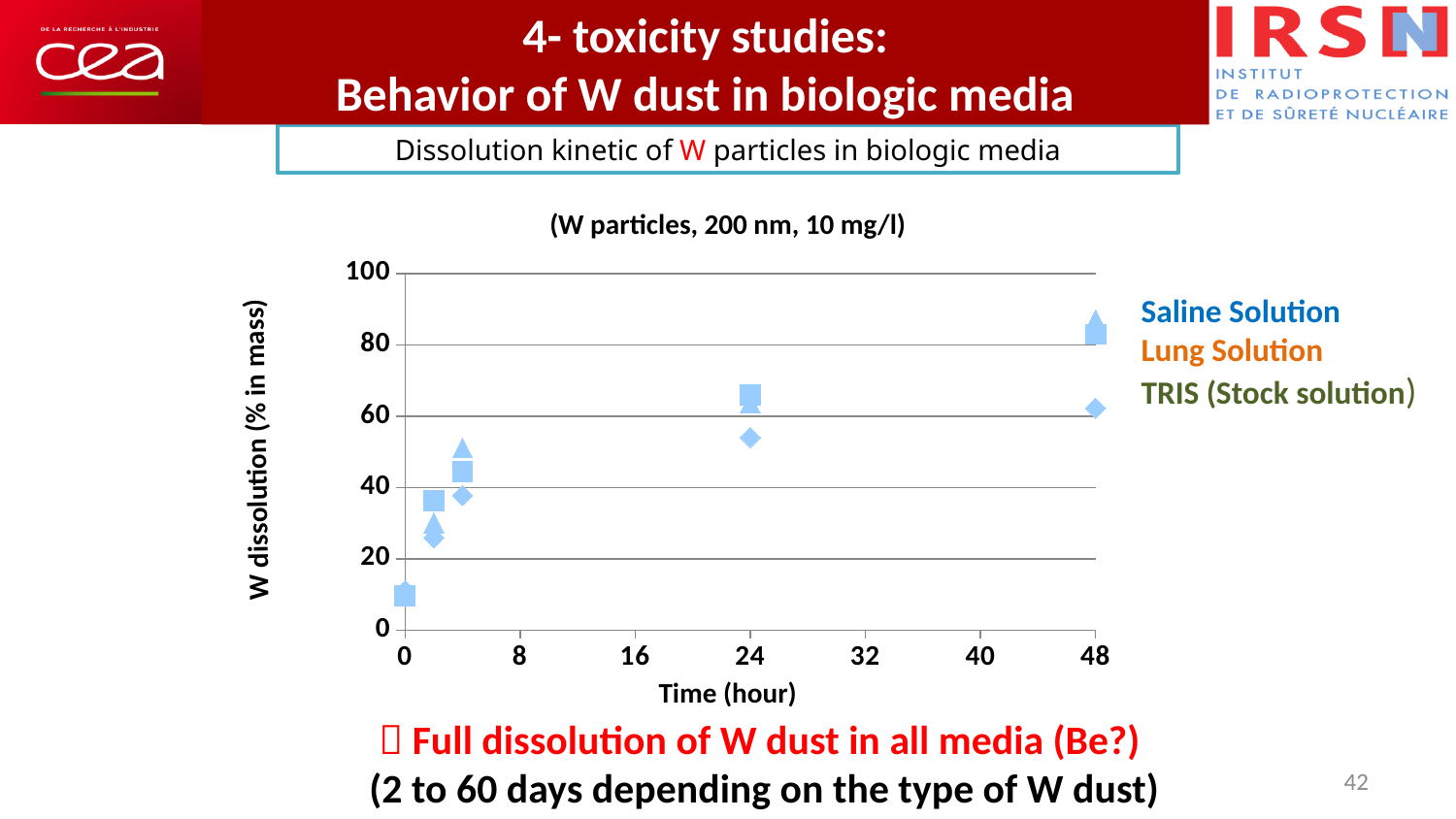
How many series does the legend of the chart list? 3 What kind of chart is shown on the slide? Scatter chart Which time point has higher W dissolution values, 24 hours or 48 hours? 48 hours What are the three series named in the chart legend? Saline Solution, Lung Solution, TRIS (Stock solution) Are the W dissolution values at 48 hours greater or less than 60? greater Are the W dissolution values at 24 hours greater or less than 40? greater At which time point on the x axis are the W dissolution values highest? 48 hours What is the title of the x axis of the chart? Time (hour) Is the W dissolution value at 0 hours greater or less than 20? less Do the W dissolution values rise or fall as time increases along the x axis? Rise At which time point on the x axis are the W dissolution values lowest? 0 hours